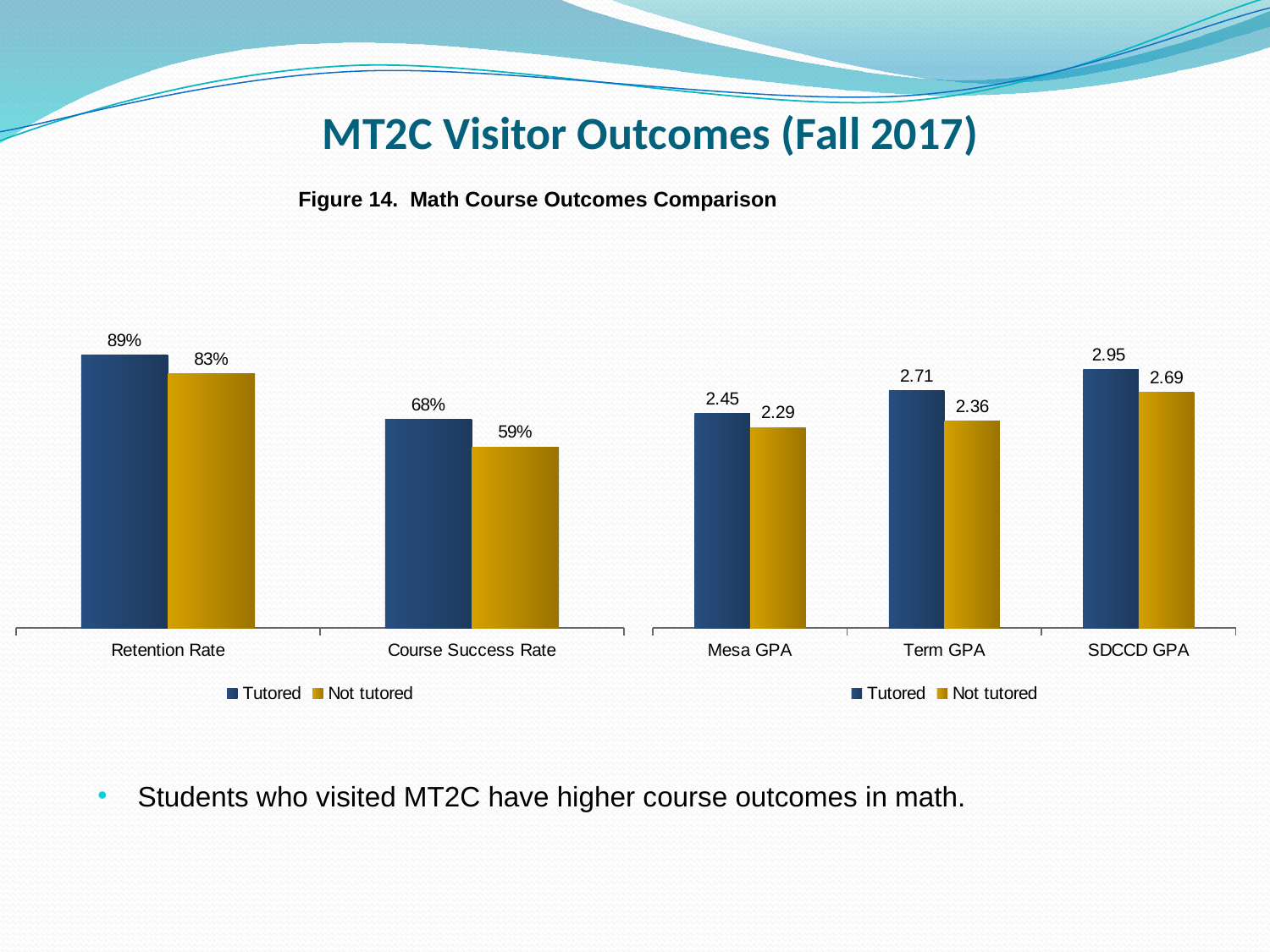
How many series does the legend of the left chart list? 2 In the right chart, what is the Tutored value for Term GPA? 2.71 In the left chart, which is larger: the Not tutored value for Retention Rate or the Tutored value for Course Success Rate? Not tutored value for Retention Rate What type of chart is the left chart? Bar chart In the left chart, what is the Not tutored value for Course Success Rate? 59% In the left chart, what is the Tutored value for Retention Rate? 89% In the left chart, what is the difference between the Tutored and Not tutored values for Course Success Rate? 9% In the right chart, which category has the highest Tutored value? SDCCD GPA In the right chart, what is the difference between the Tutored and Not tutored values for Mesa GPA? 0.16 In the right chart, what is the Not tutored value for SDCCD GPA? 2.69 How many categories are shown in the right chart? 3 In the right chart, which category has the lowest Not tutored value? Mesa GPA